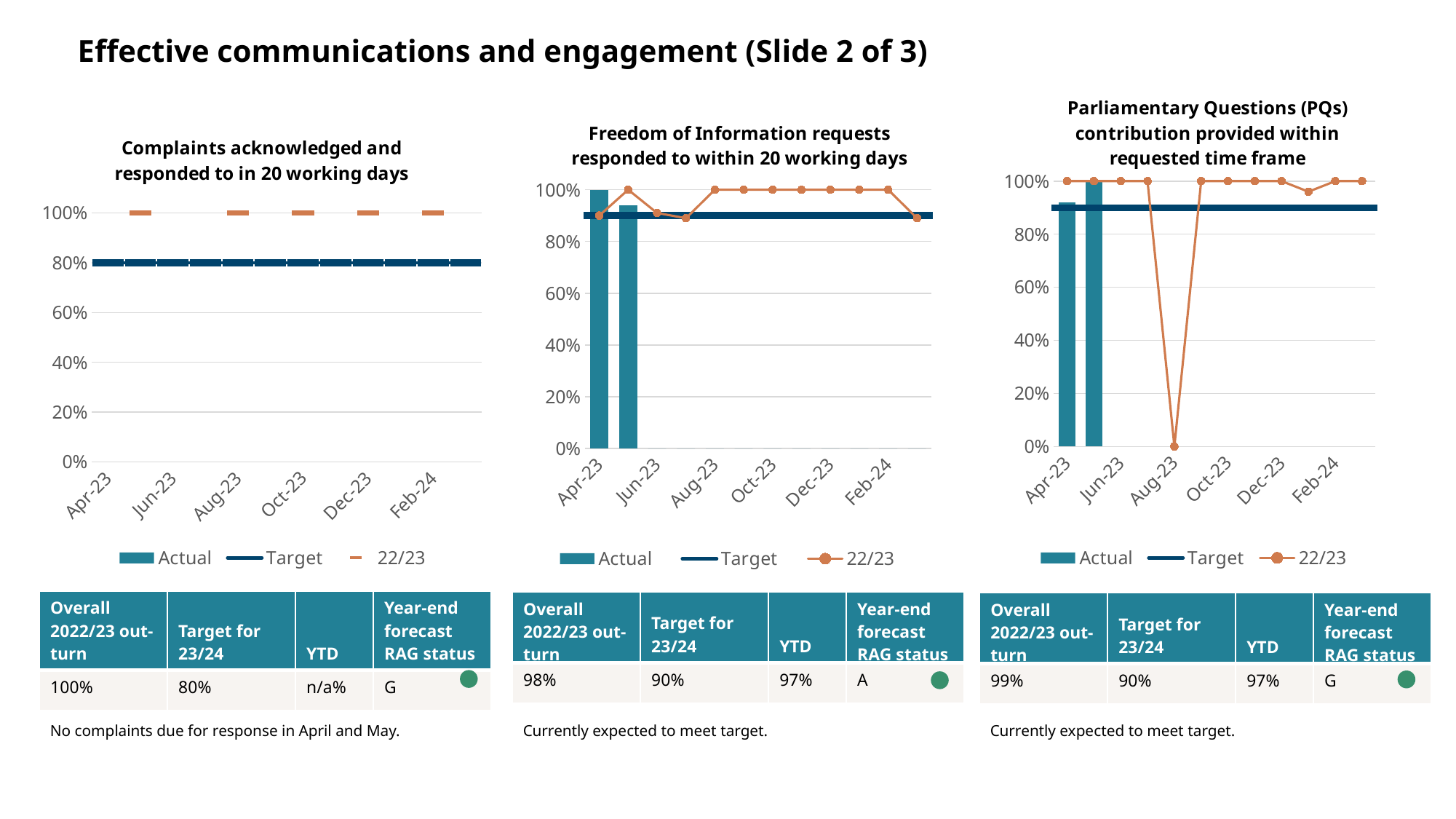
On the 'Freedom of Information requests responded to within 20 working days' chart, is the Actual value for May-23 greater or less than 80%? greater On the 'Parliamentary Questions (PQs) contribution provided within requested time frame' chart, is the Actual value for Apr-23 greater or less than 80%? greater On the 'Complaints acknowledged and responded to in 20 working days' chart, at what value is the Target line drawn? 80% What are the three legend entries on the 'Complaints acknowledged and responded to in 20 working days' chart? Actual, Target, 22/23 What kind of chart is the 'Parliamentary Questions (PQs) contribution provided within requested time frame' chart? Combination bar and line chart On the 'Freedom of Information requests responded to within 20 working days' chart, what is the Actual value for Apr-23? 100% On the 'Parliamentary Questions (PQs) contribution provided within requested time frame' chart, which month has the lowest 22/23 value? Aug-23 How many series does the legend list on the 'Freedom of Information requests responded to within 20 working days' chart? 3 On the 'Freedom of Information requests responded to within 20 working days' chart, which month has the higher Actual bar, Apr-23 or May-23? Apr-23 On the 'Parliamentary Questions (PQs) contribution provided within requested time frame' chart, what is the 22/23 value for Aug-23? 0% On the 'Freedom of Information requests responded to within 20 working days' chart, how many points are plotted on the 22/23 line? 12 On the 'Parliamentary Questions (PQs) contribution provided within requested time frame' chart, how many Actual bars are plotted? 2